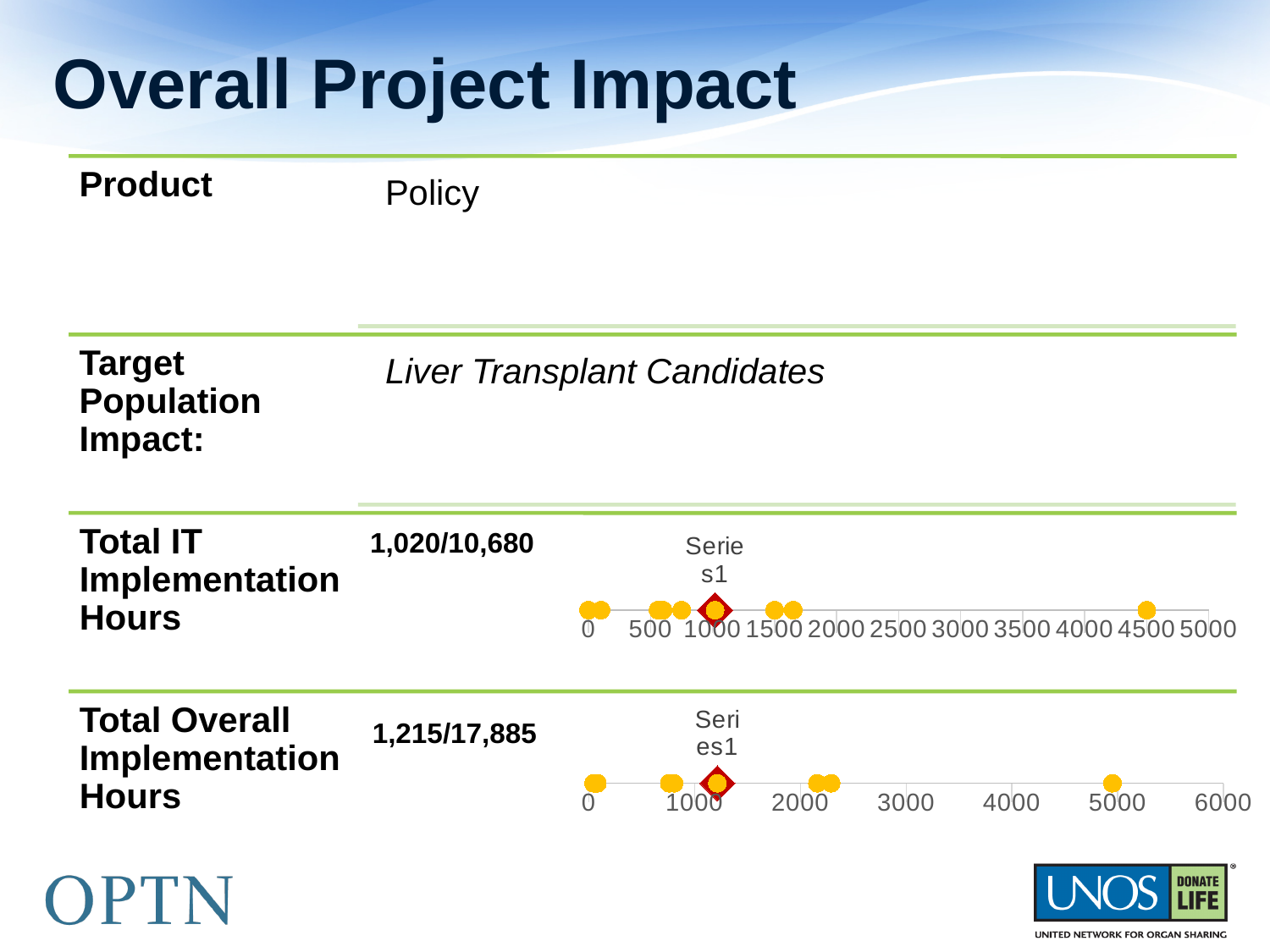
In the chart next to "Total Overall Implementation Hours", is the highlighted point labelled Series1 greater or less than 500? greater What kind of chart is shown next to "Total IT Implementation Hours"? scatter (dot) chart In the chart next to "Total Overall Implementation Hours", is the highlighted point labelled Series1 greater or less than 3000? less In the chart next to "Total IT Implementation Hours", is the highlighted point labelled Series1 greater or less than 2000? less What is the highest axis tick value shown on the chart next to "Total IT Implementation Hours"? 5000 What is the highest axis tick value shown on the chart next to "Total Overall Implementation Hours"? 6000 What kind of chart is shown next to "Total Overall Implementation Hours"? scatter (dot) chart